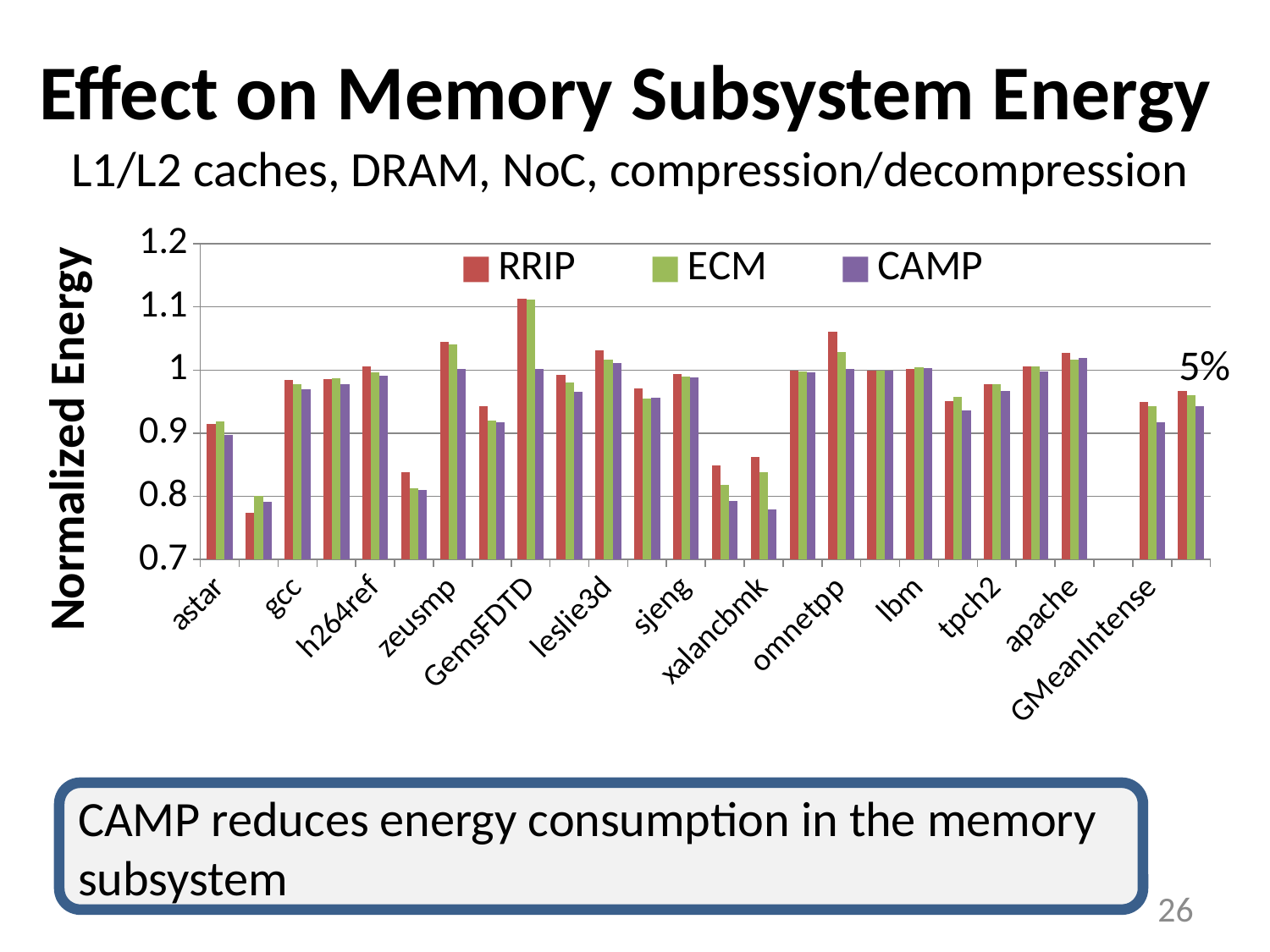
What kind of chart is shown on the slide? bar chart For GMeanIntense, which is larger: the RRIP value or the CAMP value? RRIP Which labeled benchmark has the highest RRIP value? GemsFDTD How many series does the chart's legend list? 3 Is the RRIP value for xalancbmk greater or less than 0.9? less For omnetpp, which is larger: the RRIP value or the ECM value? RRIP What is the title of the y axis? Normalized Energy Is the RRIP value for GemsFDTD greater or less than 1? greater What are the three series named in the legend? RRIP, ECM, CAMP Is the RRIP value for astar greater or less than 1? less